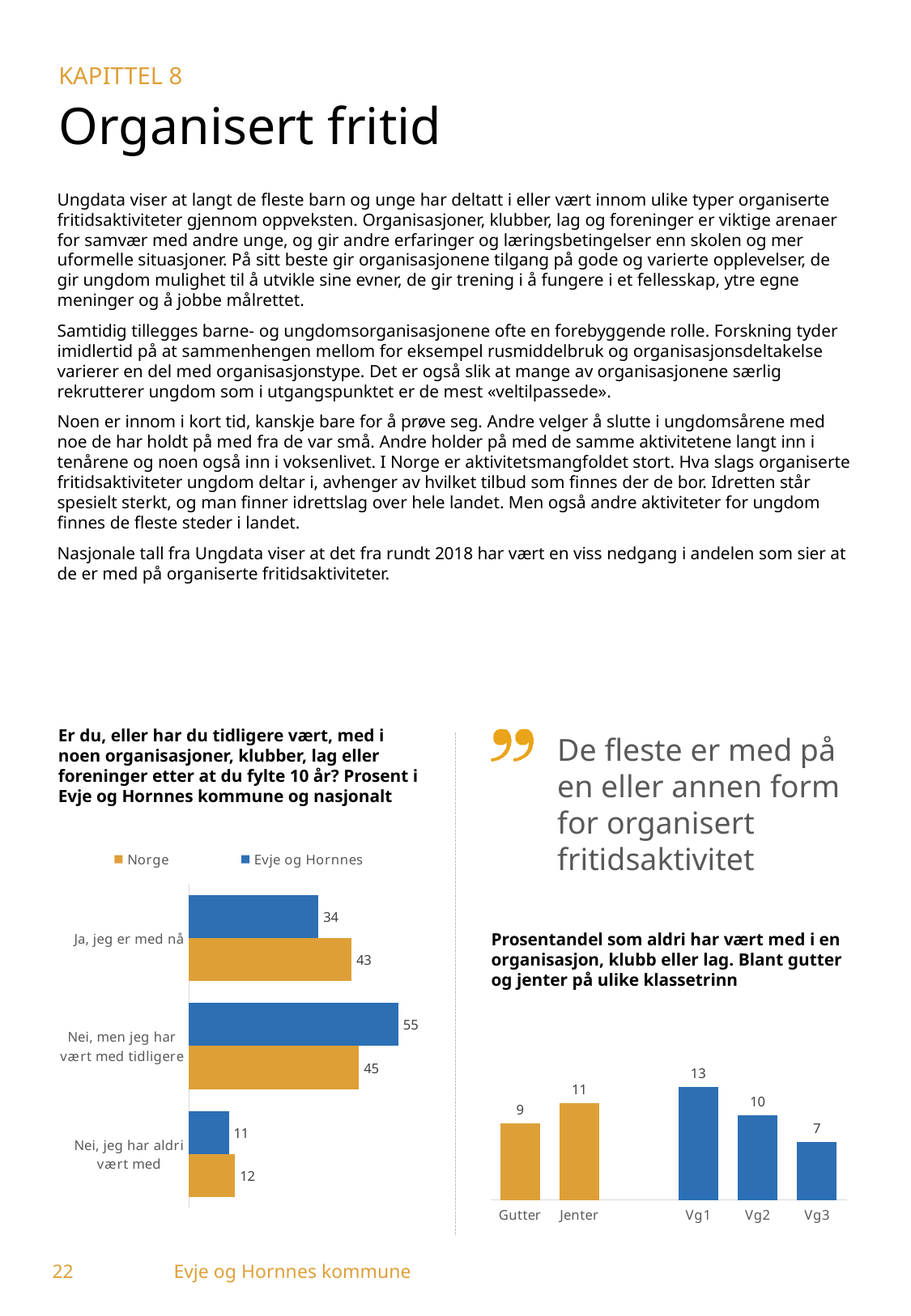
In the right chart ("Prosentandel som aldri har vært med i en organisasjon, klubb eller lag"), which category has the highest value? Vg1 In the left chart ("Er du, eller har du tidligere vært, med i noen organisasjoner..."), which category has the lowest value for Norge? Nei, jeg har aldri vært med In the left chart ("Er du, eller har du tidligere vært, med i noen organisasjoner..."), which is larger for "Ja, jeg er med nå": Norge or Evje og Hornnes? Norge In the left chart ("Er du, eller har du tidligere vært, med i noen organisasjoner..."), what colour are the Norge bars? Orange In the left chart ("Er du, eller har du tidligere vært, med i noen organisasjoner..."), what is the difference between Evje og Hornnes and Norge for "Nei, men jeg har vært med tidligere"? 10 In the right chart ("Prosentandel som aldri har vært med i en organisasjon, klubb eller lag"), what is the value for Jenter? 11 In the left chart ("Er du, eller har du tidligere vært, med i noen organisasjoner..."), what is the value for Norge for "Nei, men jeg har vært med tidligere"? 45 In the right chart ("Prosentandel som aldri har vært med i en organisasjon, klubb eller lag"), how many categories are shown? 5 In the left chart ("Er du, eller har du tidligere vært, med i noen organisasjoner..."), how many series does the legend list? 2 In the right chart ("Prosentandel som aldri har vært med i en organisasjon, klubb eller lag"), what is the difference between Vg1 and Vg3? 6 In the left chart ("Er du, eller har du tidligere vært, med i noen organisasjoner..."), what is the value for Evje og Hornnes for "Ja, jeg er med nå"? 34 In the right chart ("Prosentandel som aldri har vært med i en organisasjon, klubb eller lag"), which category has the lowest value? Vg3